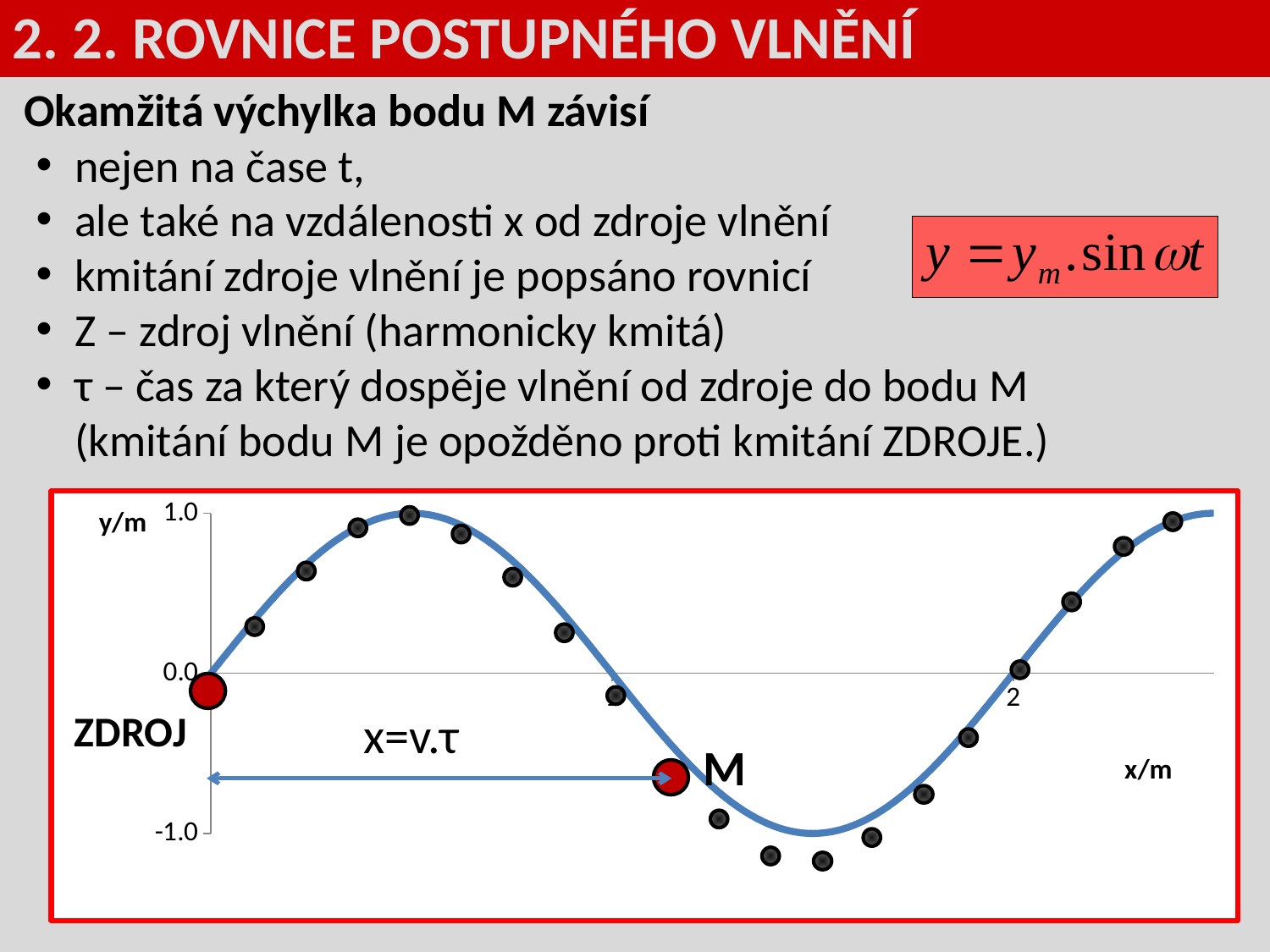
What kind of chart is shown on the slide? line chart What is the y value of the point labelled ZDROJ? 0.0 Do the plotted values rise or fall along the x axis from the peak of the wave to the point labelled M? fall Is the y value of the point labelled M greater or less than 0.0? less Is the y value of the highest plotted point greater or less than 0.0? greater Do the plotted values rise or fall along the x axis from the lowest point of the wave to the right edge of the chart? rise What is the label of the vertical axis of the chart? y/m What label is given to the red point at the origin of the chart? ZDROJ Which has the larger y value, the point labelled ZDROJ or the point labelled M? ZDROJ Do the plotted values rise or fall along the x axis from the point ZDROJ to the peak of the wave? rise